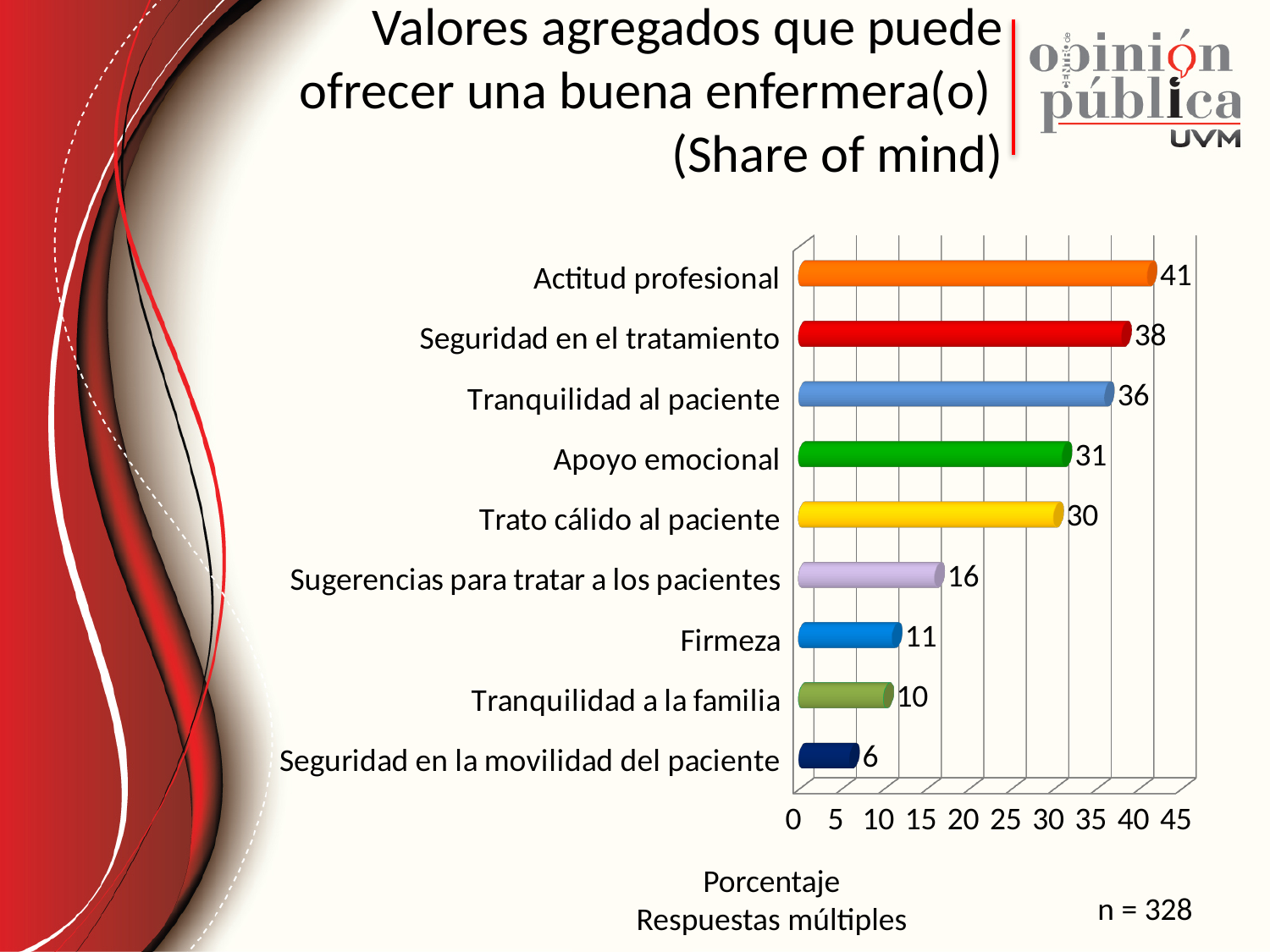
What is the difference between the values for Trato cálido al paciente and Firmeza? 19 Which category has the highest value? Actitud profesional What is the value for Actitud profesional? 41 Which is larger, the value for Sugerencias para tratar a los pacientes or the value for Firmeza? Sugerencias para tratar a los pacientes What kind of chart is shown on the slide? bar chart Is the value for Tranquilidad al paciente greater or less than 30? greater What is the value for Tranquilidad a la familia? 10 What is the value for Apoyo emocional? 31 Which category has the lowest value? Seguridad en la movilidad del paciente What is the sample size (n) shown on the slide? 328 What is the difference between the values for Seguridad en el tratamiento and Tranquilidad al paciente? 2 How many categories are shown in the chart? 9